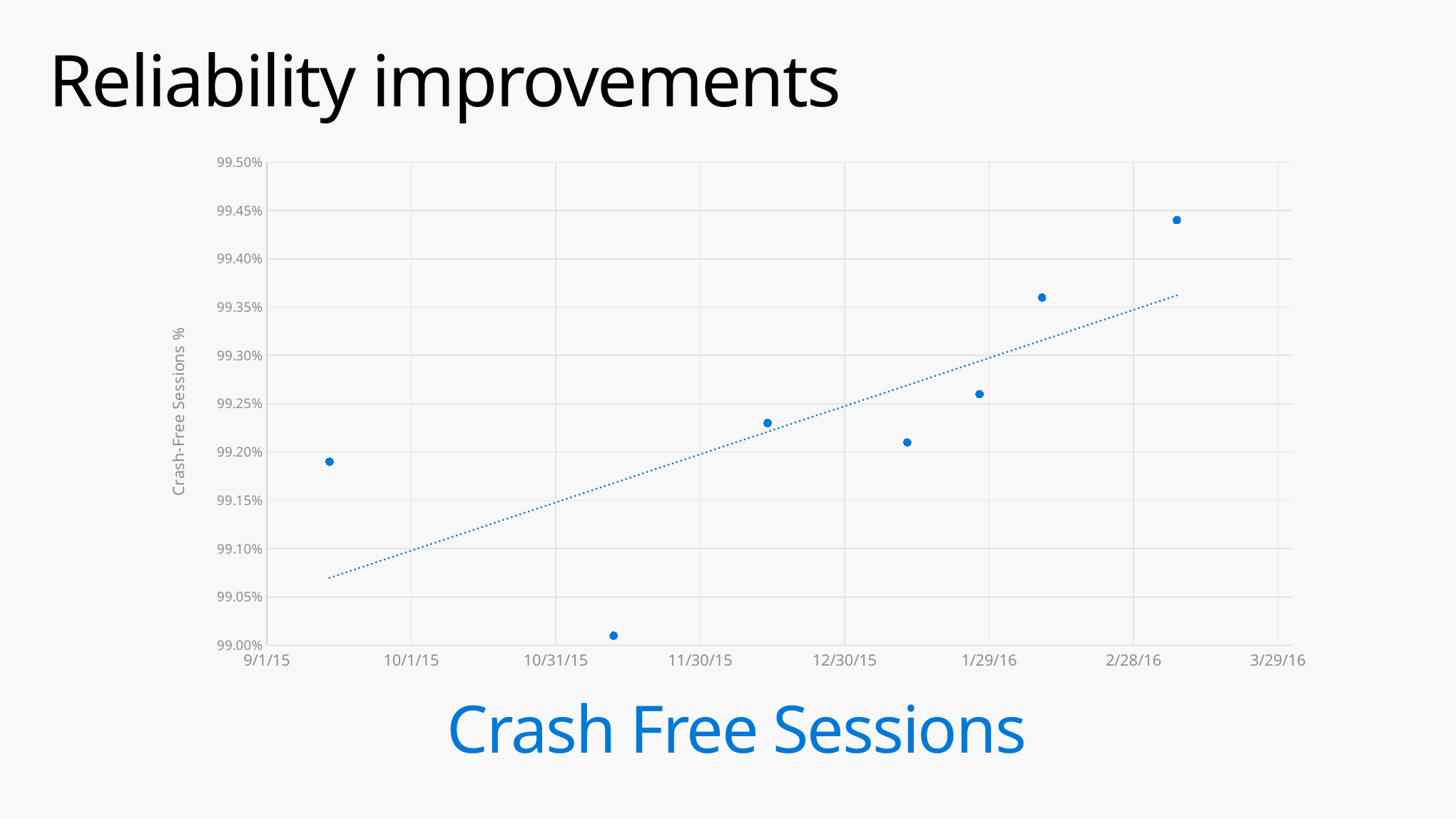
How many data points are plotted on the chart? 7 Is the point plotted in mid-December 2015 greater or less than 99.20%? greater Is the highest plotted point greater or less than 99.40%? greater Which is higher: the last plotted point (March 2016) or the first plotted point (September 2015)? the last plotted point (March 2016) In which month does the lowest plotted point fall? November 2015 What kind of chart is shown on the slide? scatter chart What is the label on the vertical axis of the chart? Crash-Free Sessions % Do the plotted crash-free session values generally rise or fall over time along the x axis? rise What is the caption shown below the chart? Crash Free Sessions In which month does the highest plotted point fall? March 2016 Is the lowest plotted point greater or less than 99.05%? less